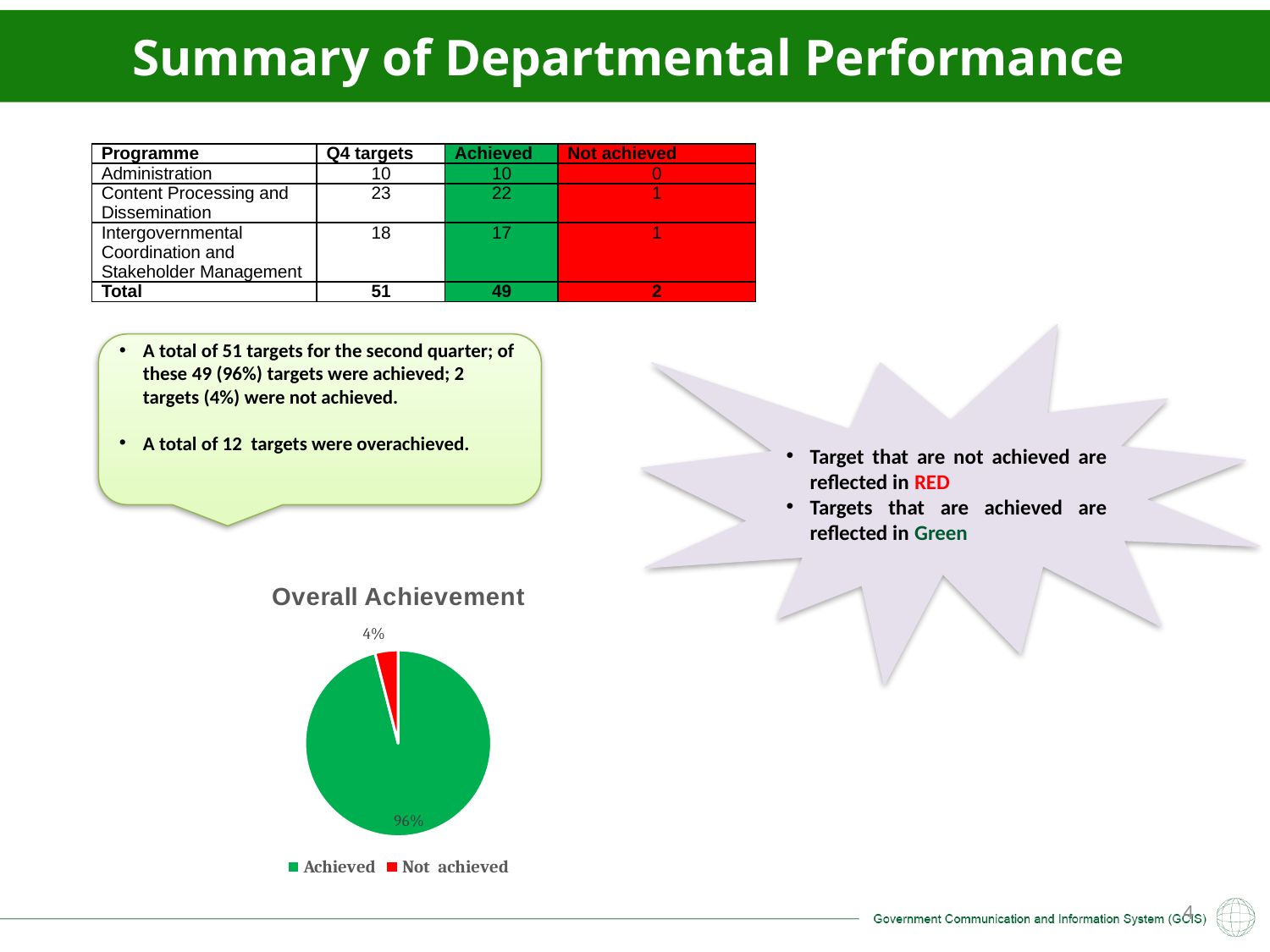
What kind of chart is shown on the slide? pie chart How many slices does the pie chart have? 2 What share of the pie chart is labelled Achieved? 96% How many entries does the pie chart legend list? 2 Which is larger in the pie chart, Achieved or Not achieved? Achieved Which slice of the pie chart is the smallest? Not achieved Which slice of the pie chart is the largest? Achieved What is the difference in percentage points between the Achieved and Not achieved slices? 92 What colour is the Not achieved slice in the pie chart? red What is the title of the pie chart? Overall Achievement What share of the pie chart is labelled Not achieved? 4%